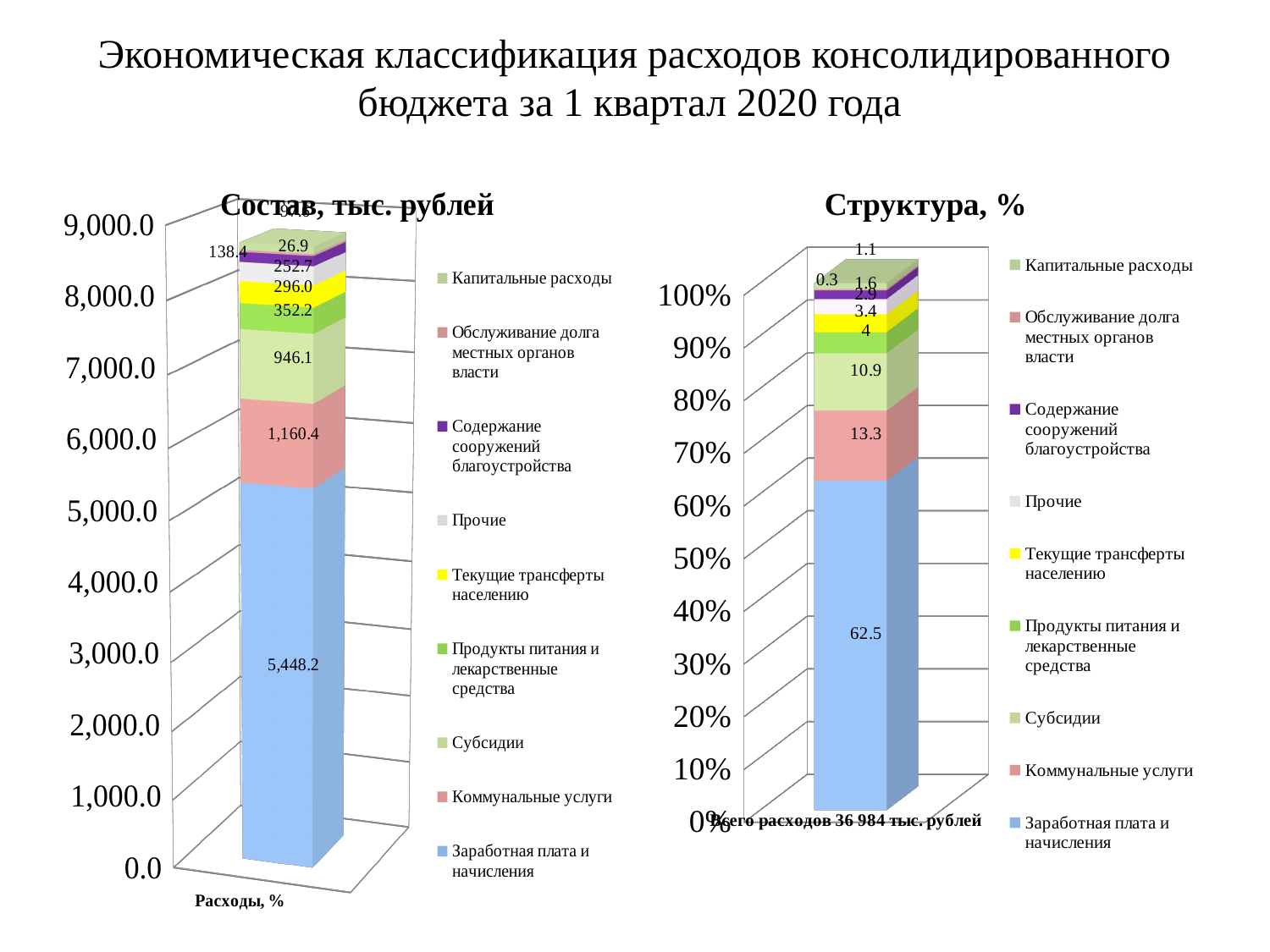
In the chart 'Структура, %', what is the value for Заработная плата и начисления? 62.5 In the chart 'Состав, тыс. рублей', what is the difference between Коммунальные услуги and Субсидии? 214.3 What kind of chart is the chart 'Состав, тыс. рублей'? Stacked bar chart In the chart 'Состав, тыс. рублей', what is the value for Заработная плата и начисления? 5,448.2 How many series does the legend of the chart 'Структура, %' list? 9 In the chart 'Состав, тыс. рублей', which is larger: Продукты питания и лекарственные средства or Текущие трансферты населению? Продукты питания и лекарственные средства In the chart 'Структура, %', what is the value for Коммунальные услуги? 13.3 In the chart 'Состав, тыс. рублей', what is the value for Субсидии? 946.1 In the chart 'Структура, %', what is the value for Продукты питания и лекарственные средства? 4 In the chart 'Состав, тыс. рублей', which series has the largest value? Заработная плата и начисления In the chart 'Состав, тыс. рублей', what is the value for Коммунальные услуги? 1,160.4 In the chart 'Структура, %', what is the difference between Заработная плата и начисления and Коммунальные услуги? 49.2